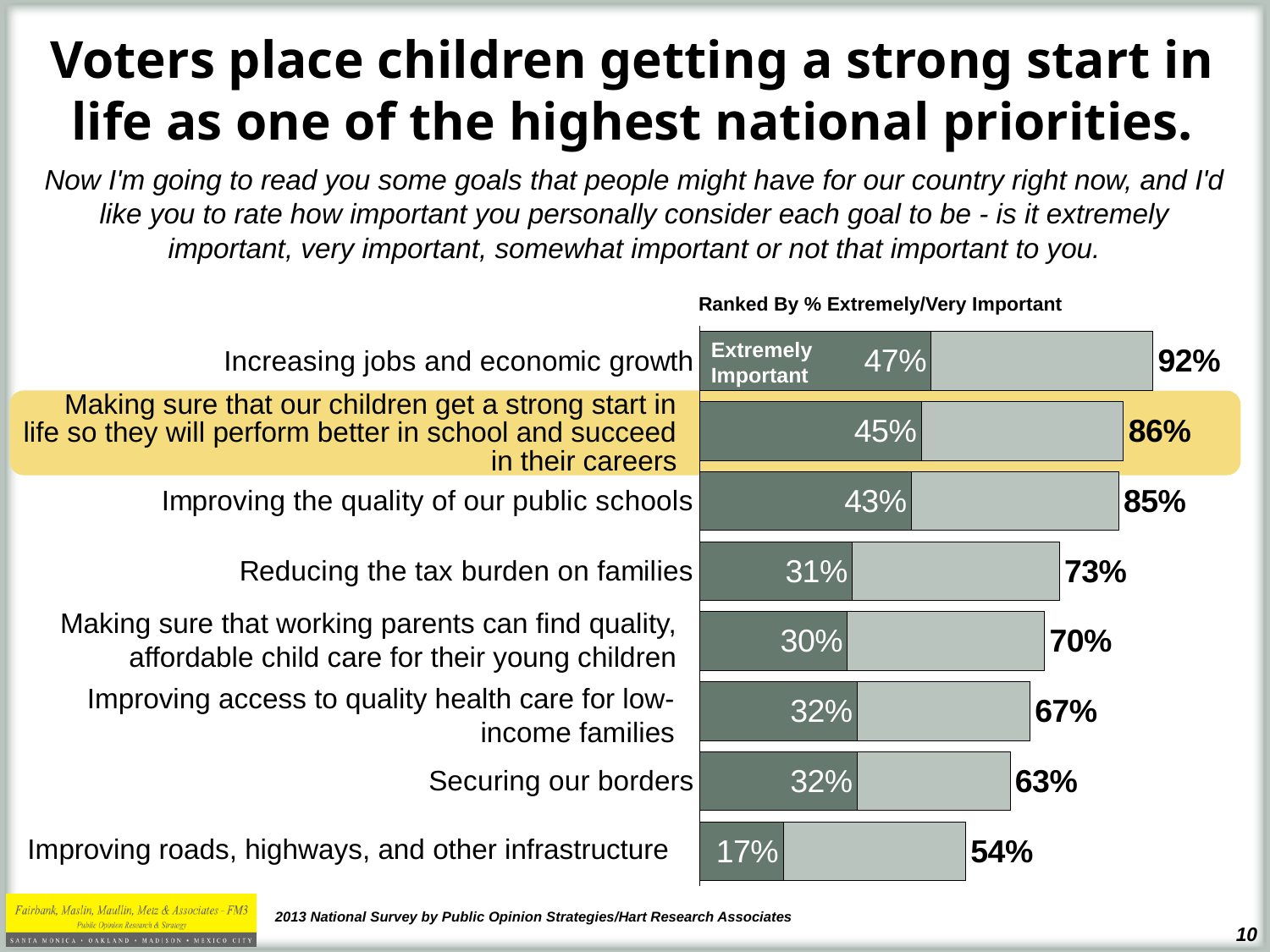
What is the combined extremely/very important percentage for "Securing our borders"? 63% According to the label above the chart, how are the goals ranked? By % Extremely/Very Important What percentage of voters rate "Increasing jobs and economic growth" as extremely important? 47% Which goal has the highest combined extremely/very important percentage? Increasing jobs and economic growth What percentage of voters rate "Improving roads, highways, and other infrastructure" as extremely important? 17% What type of chart is shown on the slide? Bar chart What is the difference between the combined extremely/very important percentages for "Increasing jobs and economic growth" and "Making sure that our children get a strong start in life so they will perform better in school and succeed in their careers"? 6% What is the difference between the combined extremely/very important percentage and the extremely important percentage for "Making sure that working parents can find quality, affordable child care for their young children"? 40% Which has a higher combined extremely/very important percentage: "Reducing the tax burden on families" or "Securing our borders"? Reducing the tax burden on families What is the combined extremely/very important percentage for "Improving the quality of our public schools"? 85% How many goals are shown in the chart? 8 Which goal has the lowest extremely important percentage? Improving roads, highways, and other infrastructure